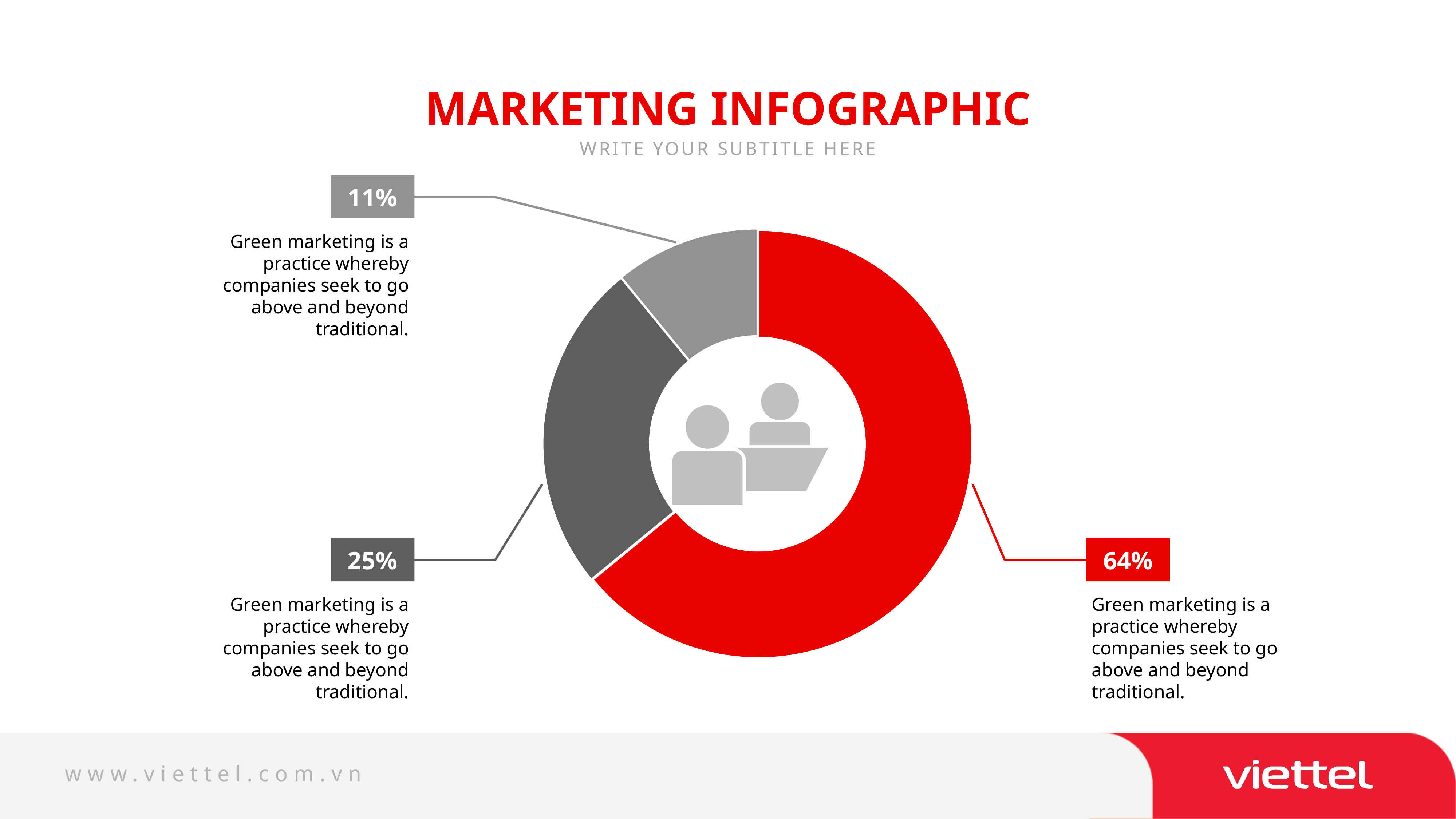
How many slices does the donut chart have? 3 What do the three percentages on the donut chart add up to? 100% What percentage is shown for the dark grey slice of the donut chart? 25% What is the difference in percentage points between the dark grey slice and the light grey slice? 14 What percentage is shown for the light grey slice of the donut chart? 11% Which slice of the donut chart is the largest? The red slice (64%) Which is larger, the dark grey slice or the light grey slice? The dark grey slice Which slice of the donut chart is the smallest? The light grey slice (11%) What is the title of the slide containing the donut chart? MARKETING INFOGRAPHIC What is the difference in percentage points between the red slice and the dark grey slice? 39 What kind of chart is shown on the slide? Donut (pie) chart What percentage is shown for the red slice of the donut chart? 64%